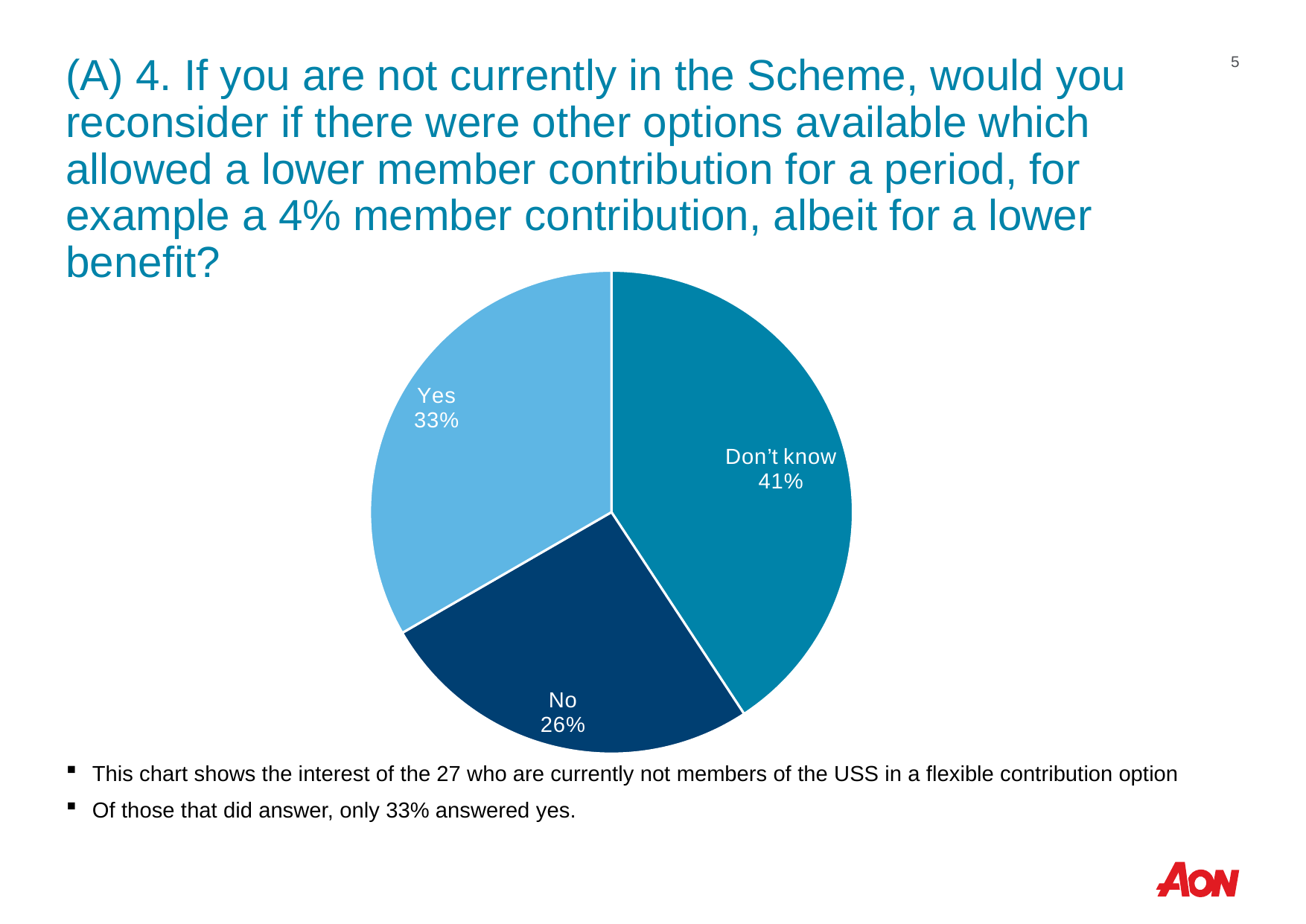
Which response has the largest share of the pie? Don't know What is the difference in percentage points between "Yes" and "No"? 7 What percentage of respondents answered "Don't know"? 41% What kind of chart is shown on the slide? pie chart What percentage of respondents answered "No"? 26% How many slices does the pie chart have? 3 What percentage of respondents answered "Yes"? 33% Which is larger, the share for "Yes" or the share for "No"? Yes Which slice of the pie is the darkest blue? No Which response has the smallest share of the pie? No Which is larger, the share for "Don't know" or the share for "Yes"? Don't know What is the difference in percentage points between "Don't know" and "No"? 15